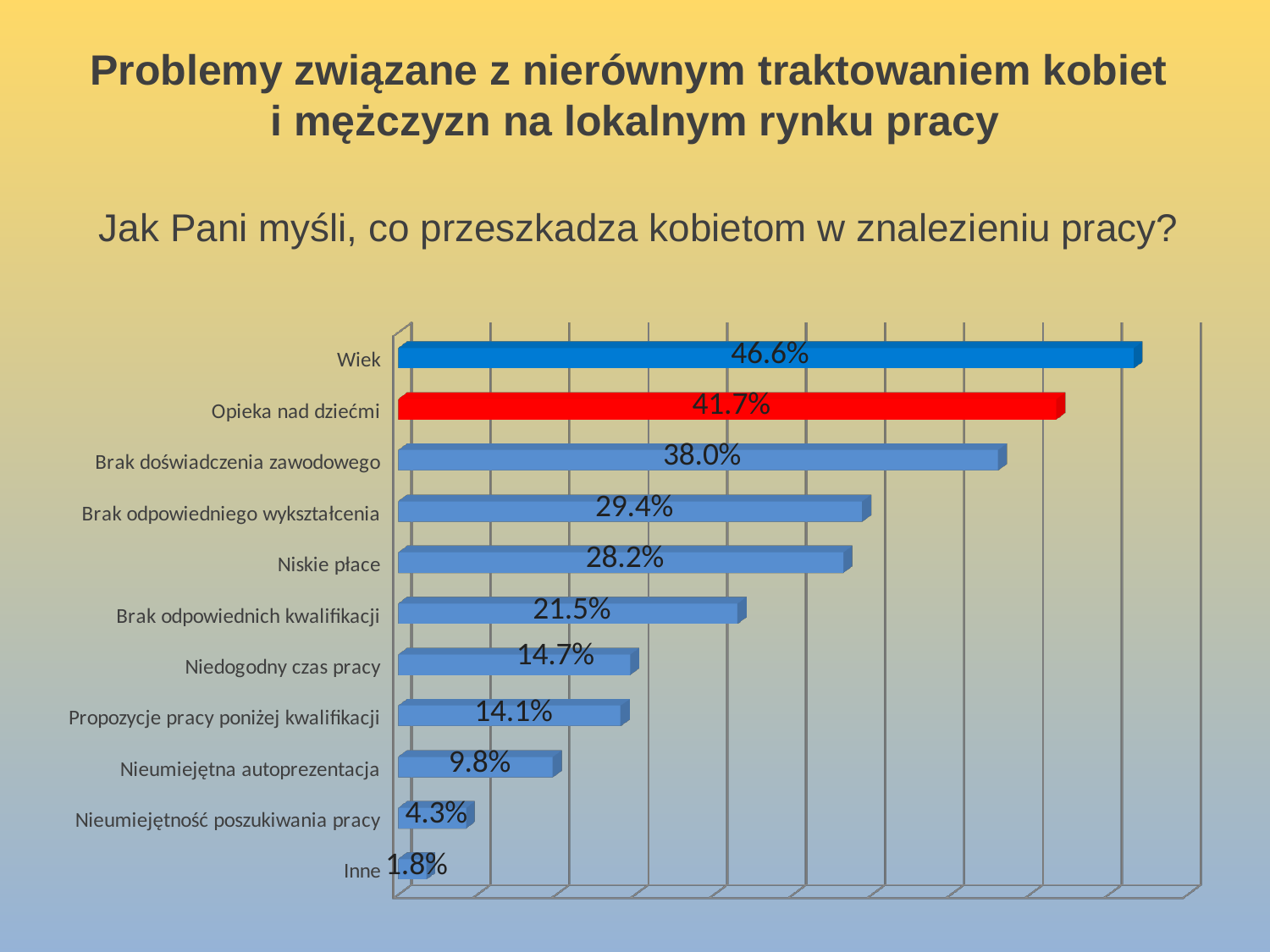
What is the value for Niskie płace? 28.2% What is the value for Nieumiejętna autoprezentacja? 9.8% Which category's bar is coloured red? Opieka nad dziećmi What is the value for Wiek? 46.6% Which category has the highest value? Wiek Which category has the lowest value? Inne What is the value for Opieka nad dziećmi? 41.7% What is the difference between the values for Brak doświadczenia zawodowego and Brak odpowiedniego wykształcenia? 8.6% How many categories are shown in the chart? 11 Which is larger, the value for Niedogodny czas pracy or the value for Brak odpowiednich kwalifikacji? Brak odpowiednich kwalifikacji What is the difference between the values for Wiek and Opieka nad dziećmi? 4.9% What kind of chart is shown on the slide? bar chart